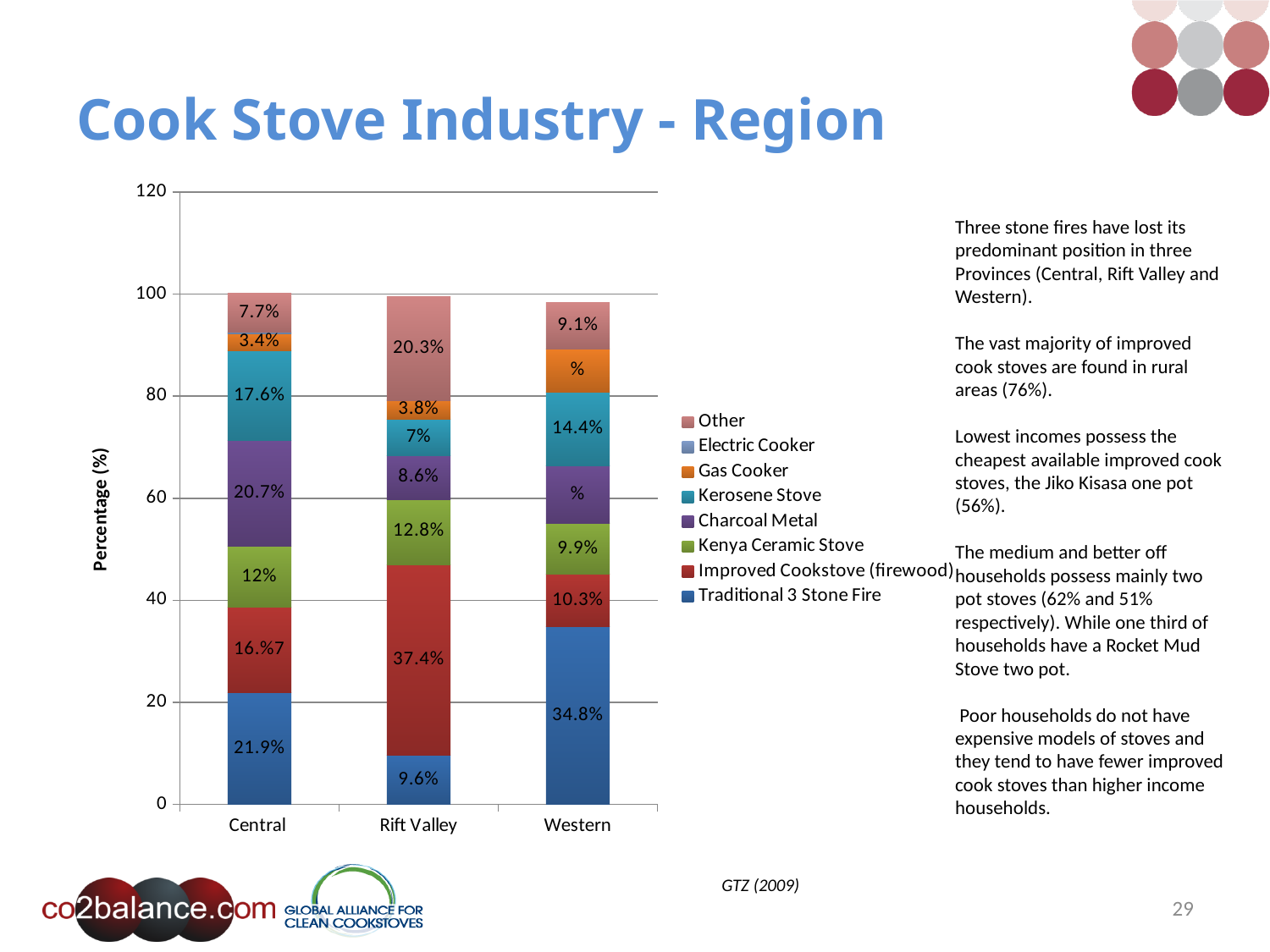
Which region has the lowest value for Traditional 3 Stone Fire? Rift Valley Which region has the highest value for Other? Rift Valley Which is larger, the Kerosene Stove value for Central or for Western? Central What is the value for Kenya Ceramic Stove in Central? 12% What kind of chart is shown on the slide? Stacked bar chart Which region has the highest value for Traditional 3 Stone Fire? Western How many series does the chart legend list? 8 What is the value for Traditional 3 Stone Fire in Rift Valley? 9.6% What is the title of the y axis? Percentage (%) What is the difference between the Improved Cookstove (firewood) values for Rift Valley and Western? 27.1 percentage points How many regions are shown on the x axis of the chart? 3 What is the value for Improved Cookstove (firewood) in Rift Valley? 37.4%